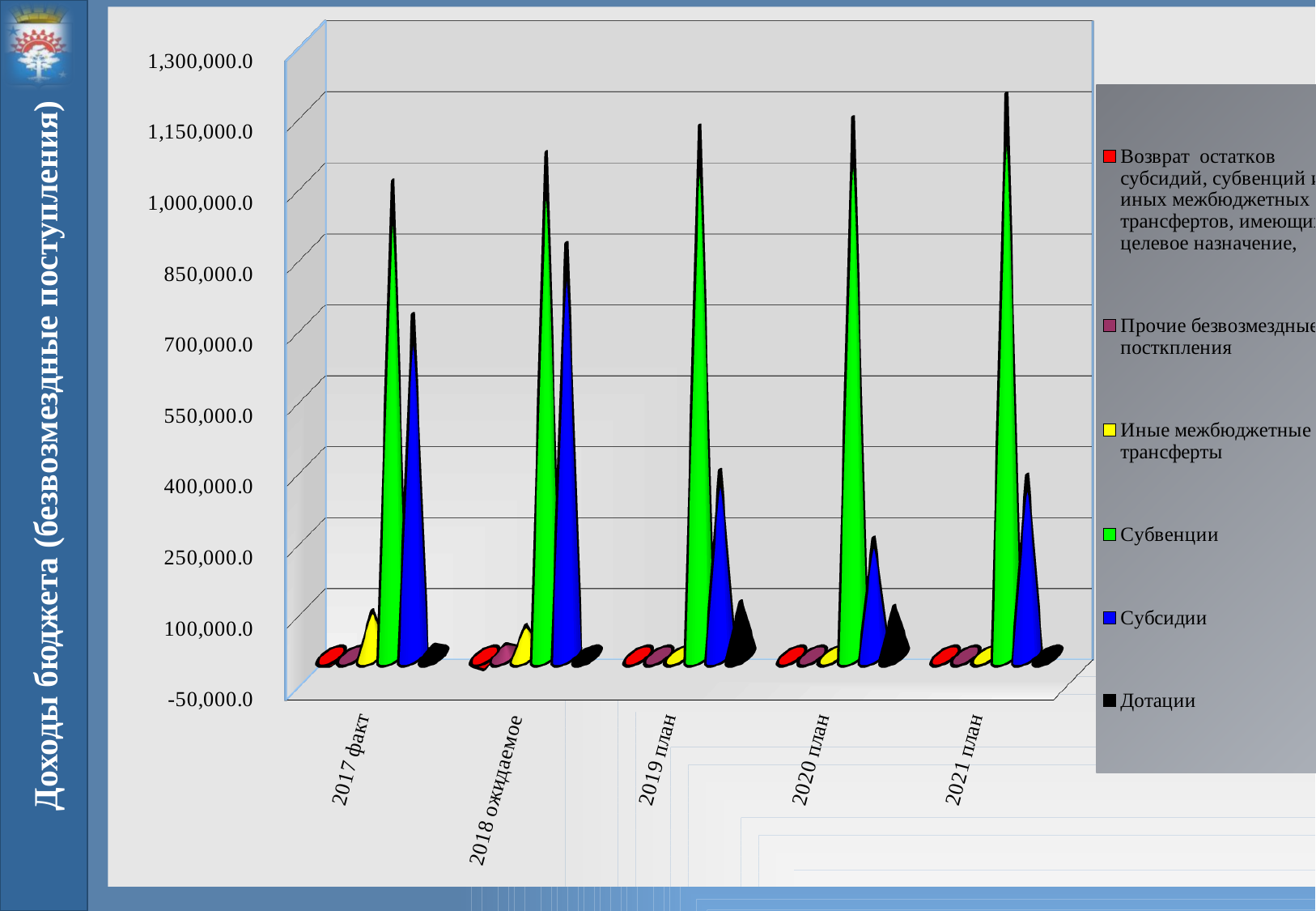
How many categories are shown on the x axis of the chart? 5 In which category is the value for Субсидии the highest? 2018 ожидаемое Is the value for Субсидии in 2018 ожидаемое greater or less than 700,000.0? greater Which colour represents Субвенции in the legend? green Do the values for Субвенции rise or fall from 2017 факт to 2021 план? rise How many series does the chart legend list? 6 Is the value for Субсидии in 2020 план greater or less than 400,000.0? less Is the value for Субвенции in 2017 факт greater or less than 850,000.0? greater In which category is the value for Субвенции the lowest? 2017 факт In which category is the value for Субвенции the highest? 2021 план In 2019 план, which is larger: Субвенции or Субсидии? Субвенции What kind of chart is shown on the slide? bar chart